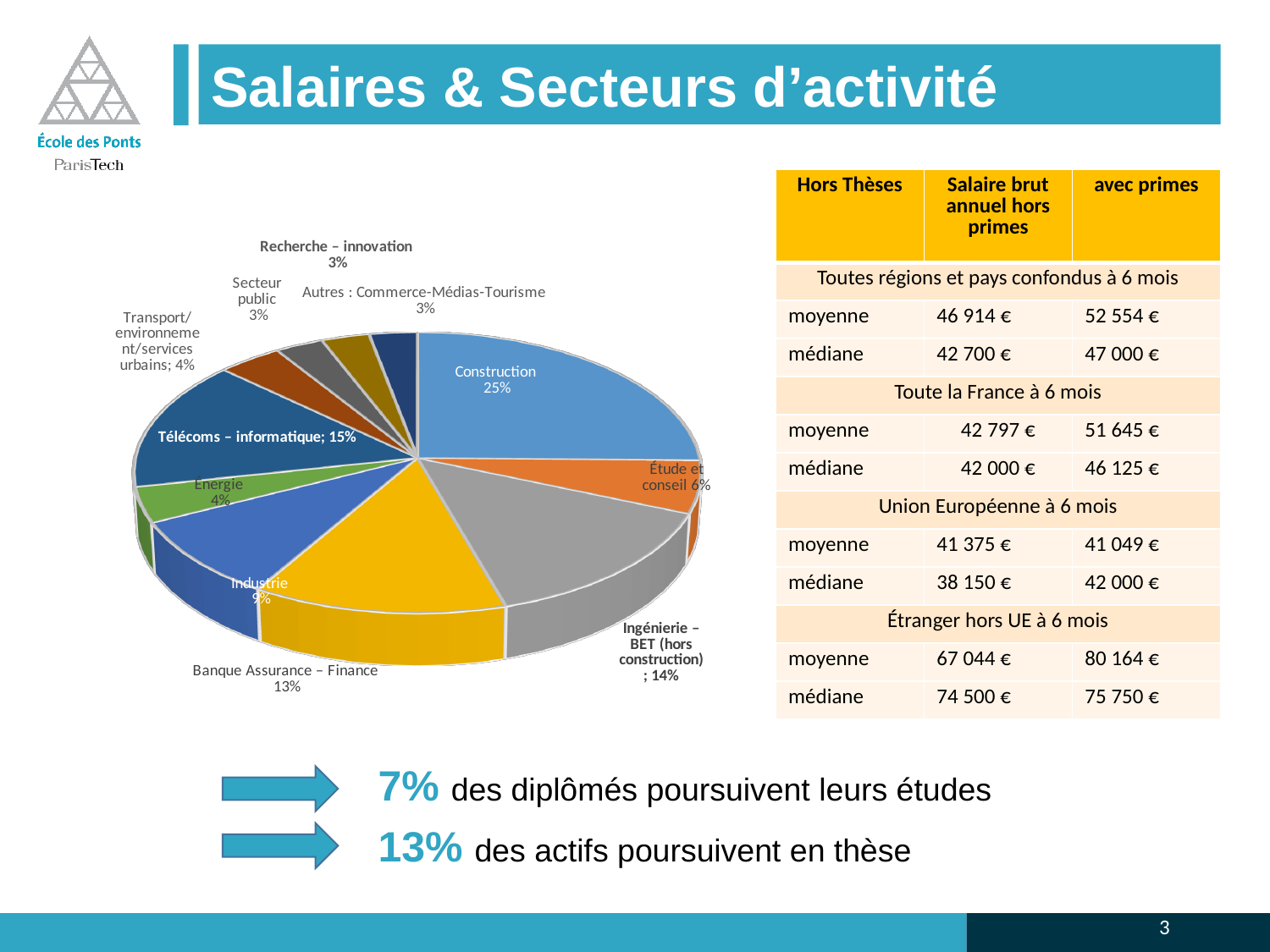
What is the value shown for Recherche – innovation in the pie chart? 3% What is the difference between the shares of Construction and Télécoms – informatique in the pie chart? 10% What is the value shown for Télécoms – informatique in the pie chart? 15% What percentage is shown for Ingénierie – BET (hors construction) in the pie chart? 14% Which sector has the largest share in the pie chart? Construction What is the share shown for Energie in the pie chart? 4% Which has a larger share in the pie chart, Étude et conseil or Industrie? Industrie What percentage does Industrie account for in the pie chart? 9% How many sectors are shown in the pie chart? 11 What is the value for Banque Assurance – Finance in the pie chart? 13% What share of the pie chart does Construction represent? 25% What kind of chart is shown on the left of the slide? Pie chart